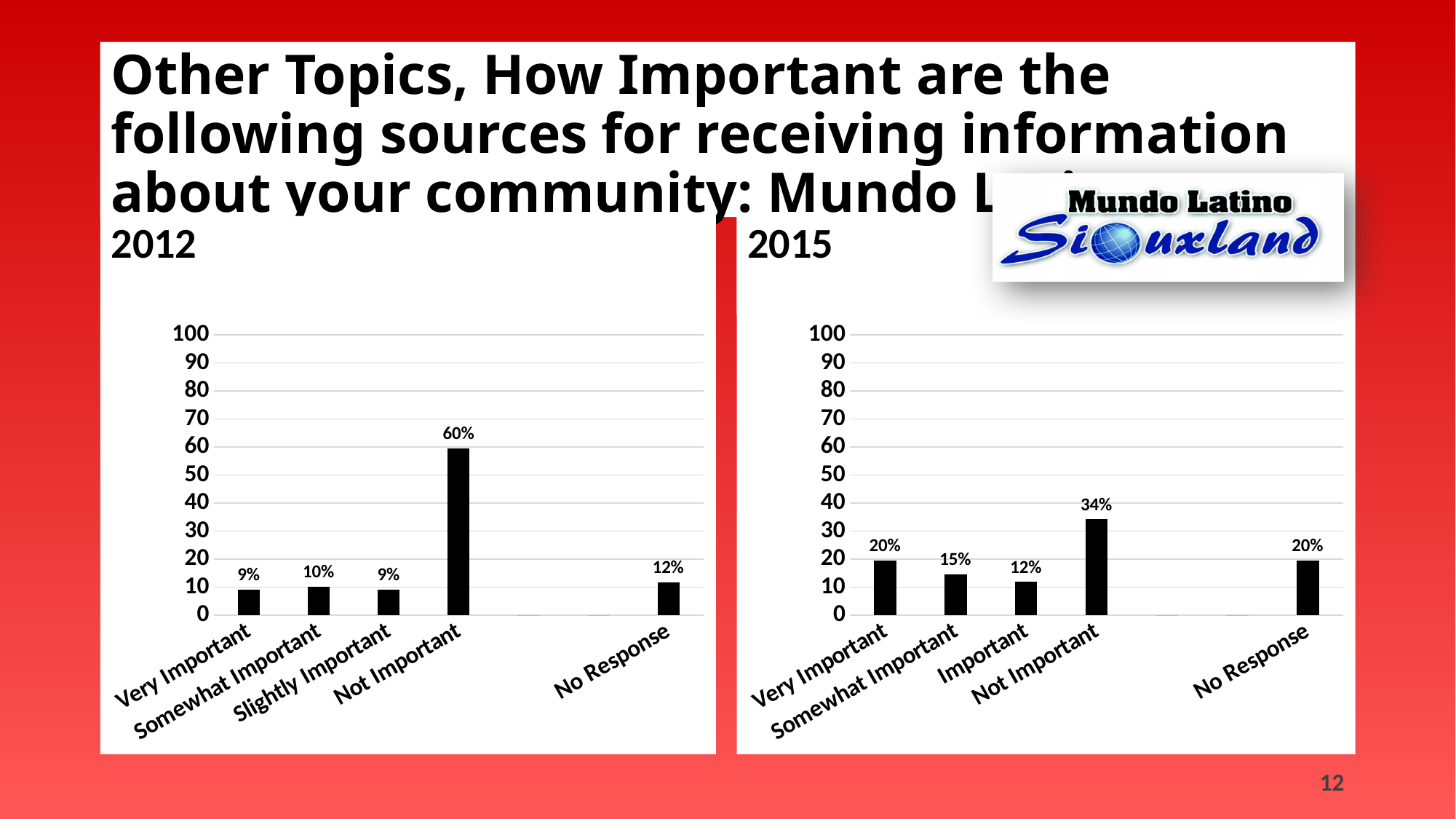
In the 2012 chart, what is the difference between Not Important and No Response? 48% In the 2015 chart, what is the value for Very Important? 20% In the 2015 chart, which category has the highest value? Not Important In the 2012 chart, is the value for Not Important greater or less than 50? greater In the 2015 chart, what is the value for Somewhat Important? 15% In the 2015 chart, which category has the lowest value? Important In the 2012 chart, what is the value for No Response? 12% Which is larger: Not Important in the 2012 chart or Not Important in the 2015 chart? Not Important in the 2012 chart What type of chart is the 2015 chart? bar chart In the 2012 chart, which category has the highest value? Not Important In the 2015 chart, what is the difference between Not Important and Very Important? 14% In the 2012 chart, what is the value for Not Important? 60%